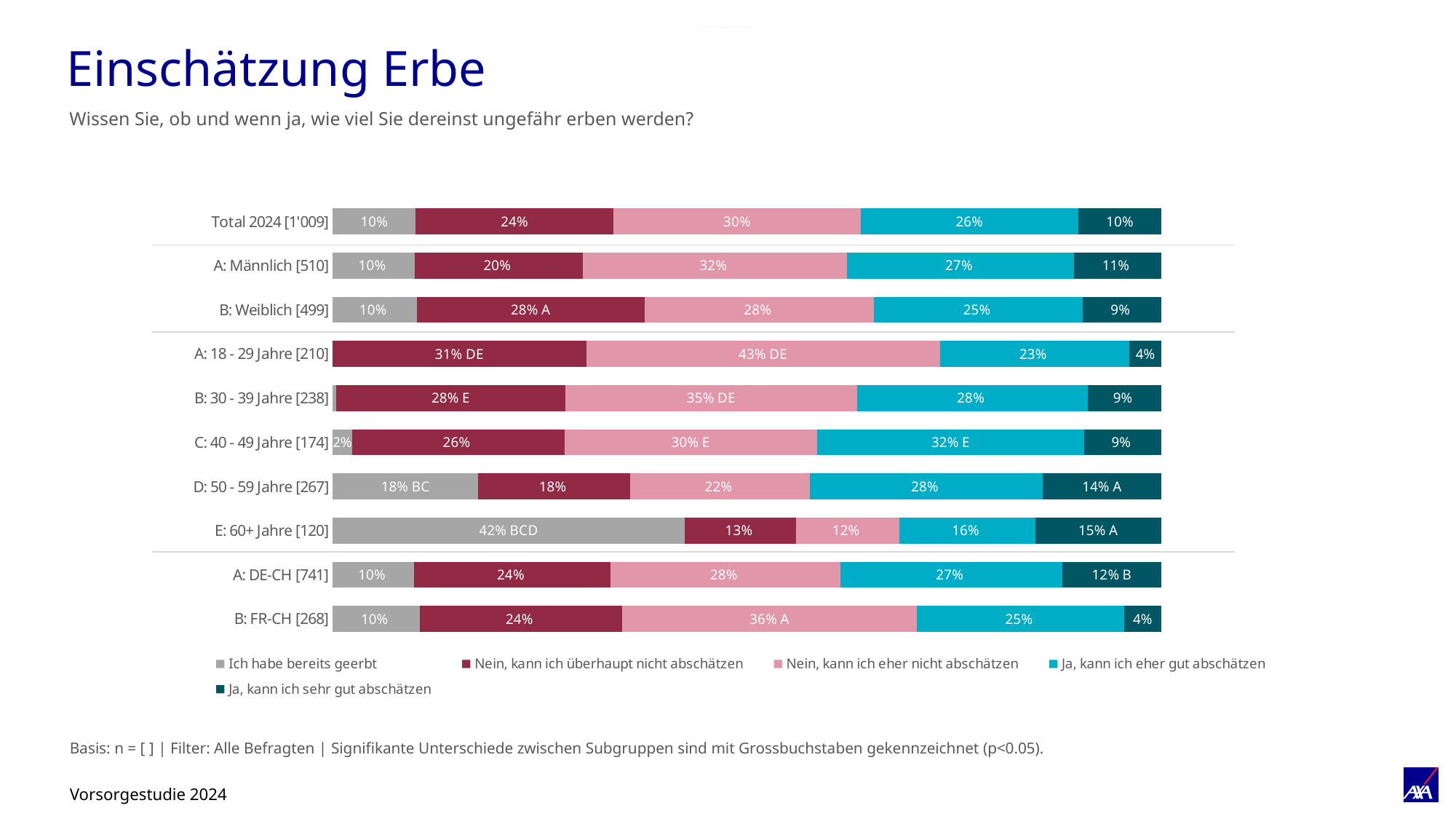
What percentage of the Total 2024 group answered "Nein, kann ich eher nicht abschätzen"? 30% What is the difference between the "Nein, kann ich überhaupt nicht abschätzen" values for B: Weiblich and A: Männlich? 8 percentage points What is the value for "Ich habe bereits geerbt" in the E: 60+ Jahre group? 42% Which age group has the highest value for "Nein, kann ich eher nicht abschätzen"? A: 18 - 29 Jahre Which age group has the lowest value for "Ja, kann ich eher gut abschätzen"? E: 60+ Jahre What is the sample size shown for the B: 30 - 39 Jahre group? 238 How many groups (bars) are shown in the chart? 10 Which is larger for the D: 50 - 59 Jahre group: "Ja, kann ich eher gut abschätzen" or "Nein, kann ich eher nicht abschätzen"? Ja, kann ich eher gut abschätzen What share of the A: 18 - 29 Jahre group answered "Ja, kann ich sehr gut abschätzen"? 4% Which has a larger value for "Nein, kann ich eher nicht abschätzen": A: DE-CH or B: FR-CH? B: FR-CH How many series does the legend list? 5 What type of chart is shown on the slide? Stacked bar chart